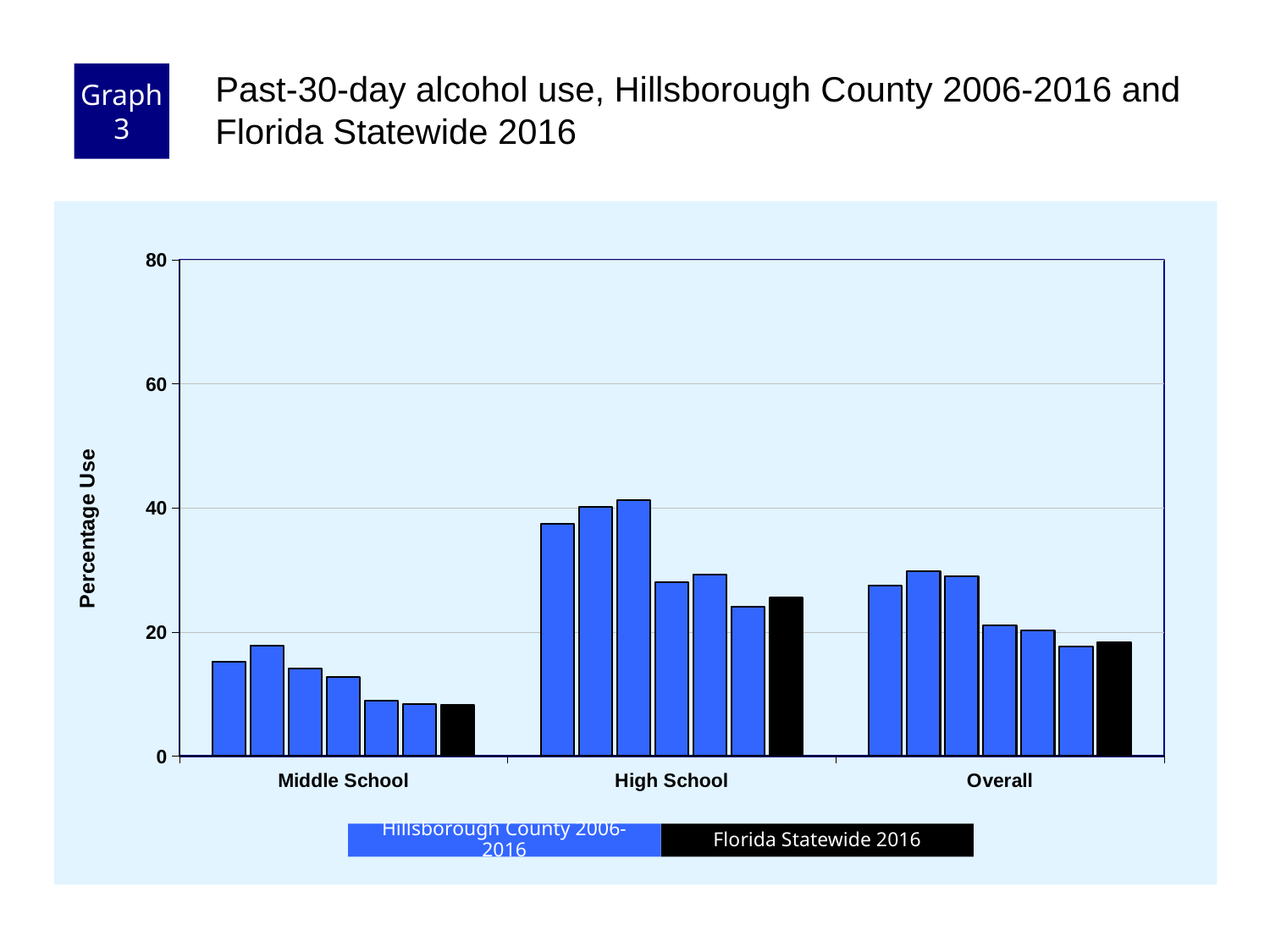
How many categories are shown on the x axis? 3 What kind of chart is shown on the slide? bar chart Which series is shown in black in the legend? Florida Statewide 2016 Is the Florida Statewide 2016 value for High School greater or less than 20? greater How many series does the legend list? 2 What is the label on the y axis? Percentage Use Which category has the lowest bars overall? Middle School Is the Florida Statewide 2016 value for Middle School greater or less than 20? less Is the first Hillsborough County bar for High School greater or less than 40? less Which category has the highest bars overall? High School Do the Hillsborough County bars for Middle School generally rise or fall from left to right? fall Is the Florida Statewide 2016 value larger for High School or for Middle School? High School